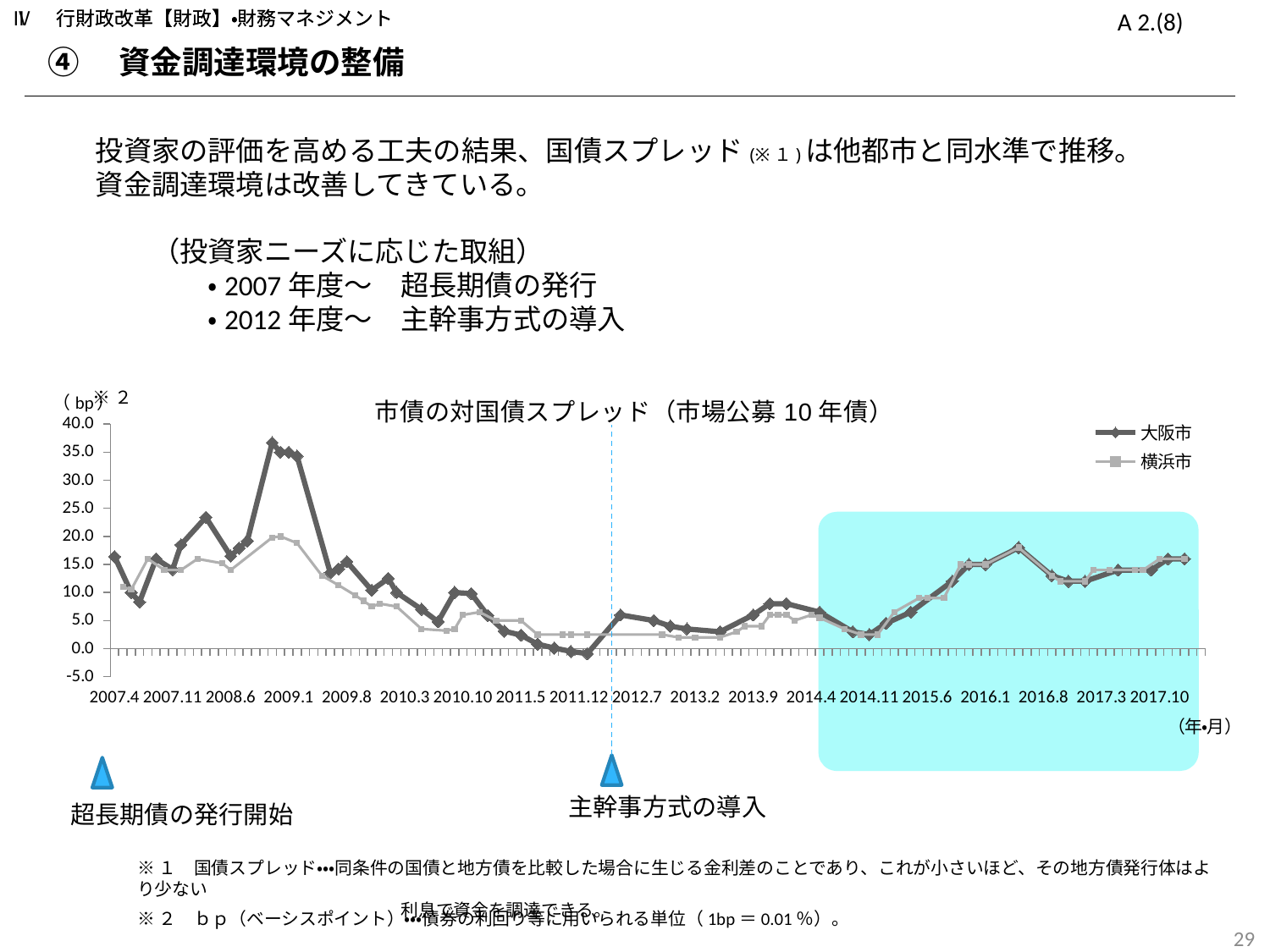
Which two series are listed in the chart legend? 大阪市 and 横浜市 How many series does the chart legend list? 2 What kind of chart is shown on the slide? line chart What is the title of the chart? 市債の対国債スプレッド（市場公募10年債） Is the value for 横浜市 at 2009.1 greater or less than 25? less Which series reaches the highest value anywhere on the chart? 大阪市 Is the value for 大阪市 at 2007.4 greater or less than 10? greater Is the value for 大阪市 at 2009.1 greater or less than 30? greater At 2009.1, which series has the higher value, 大阪市 or 横浜市? 大阪市 Does the 大阪市 line rise or fall between 2009.1 and 2011.12? fall Does the 大阪市 line rise or fall between 2014.11 and 2016.1? rise